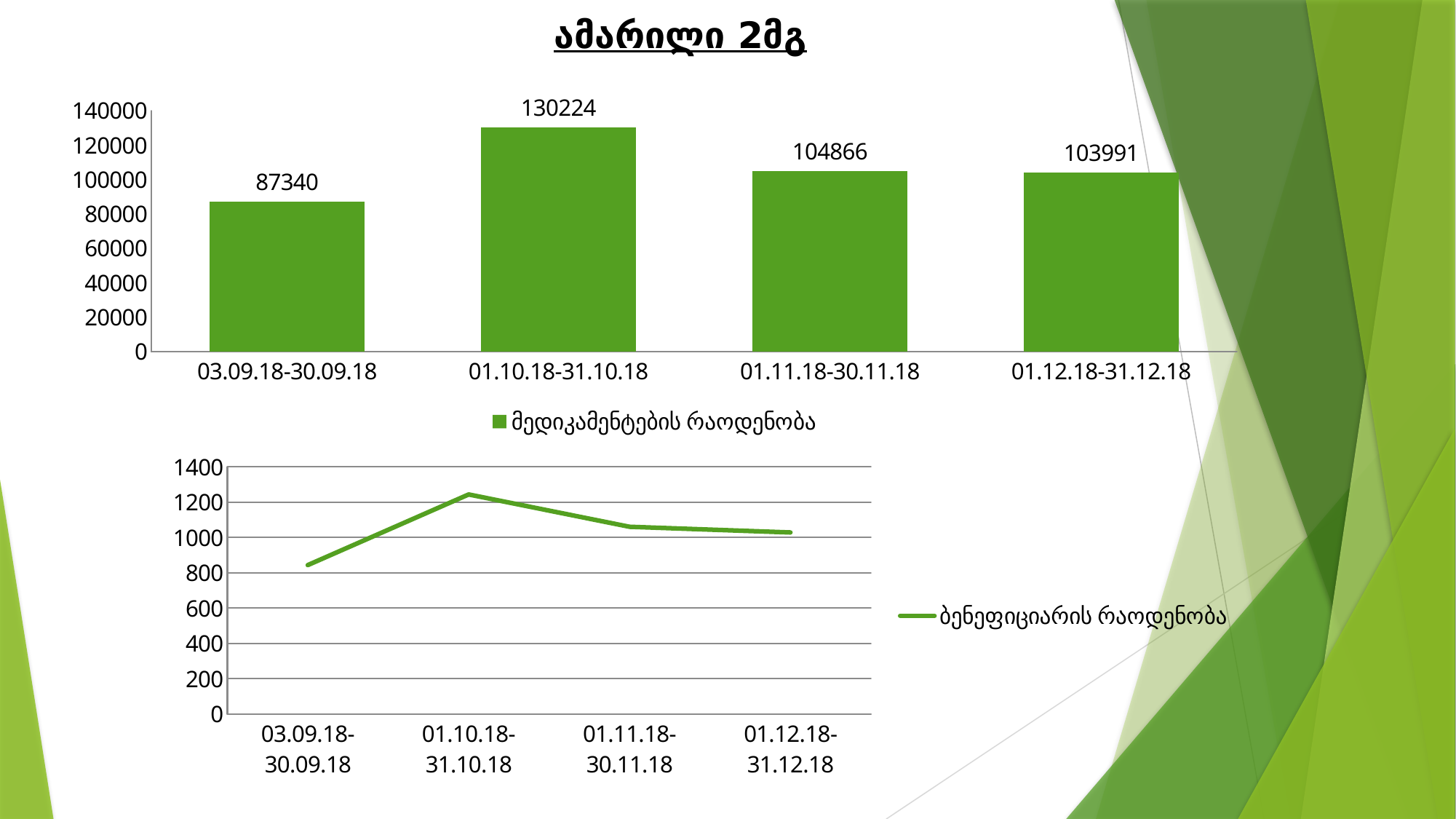
In the top bar chart, what is the value for 01.10.18-31.10.18? 130224 In the top bar chart, which period has the lowest value? 03.09.18-30.09.18 In the bottom line chart, is the value for 01.10.18-31.10.18 greater or less than 1200? greater What type of chart is the bottom chart on the slide? line chart In the top bar chart, what is the difference between the values for 01.10.18-31.10.18 and 03.09.18-30.09.18? 42884 In the top bar chart, what is the value for 01.12.18-31.12.18? 103991 In the top bar chart, which period has the highest value? 01.10.18-31.10.18 What is the legend entry of the bottom line chart? ბენეფიციარის რაოდენობა What type of chart is the top chart on the slide? bar chart In the bottom line chart, is the value for 03.09.18-30.09.18 greater or less than 1000? less In the top bar chart, how many bars are there? 4 In the top bar chart, what is the value for 03.09.18-30.09.18? 87340